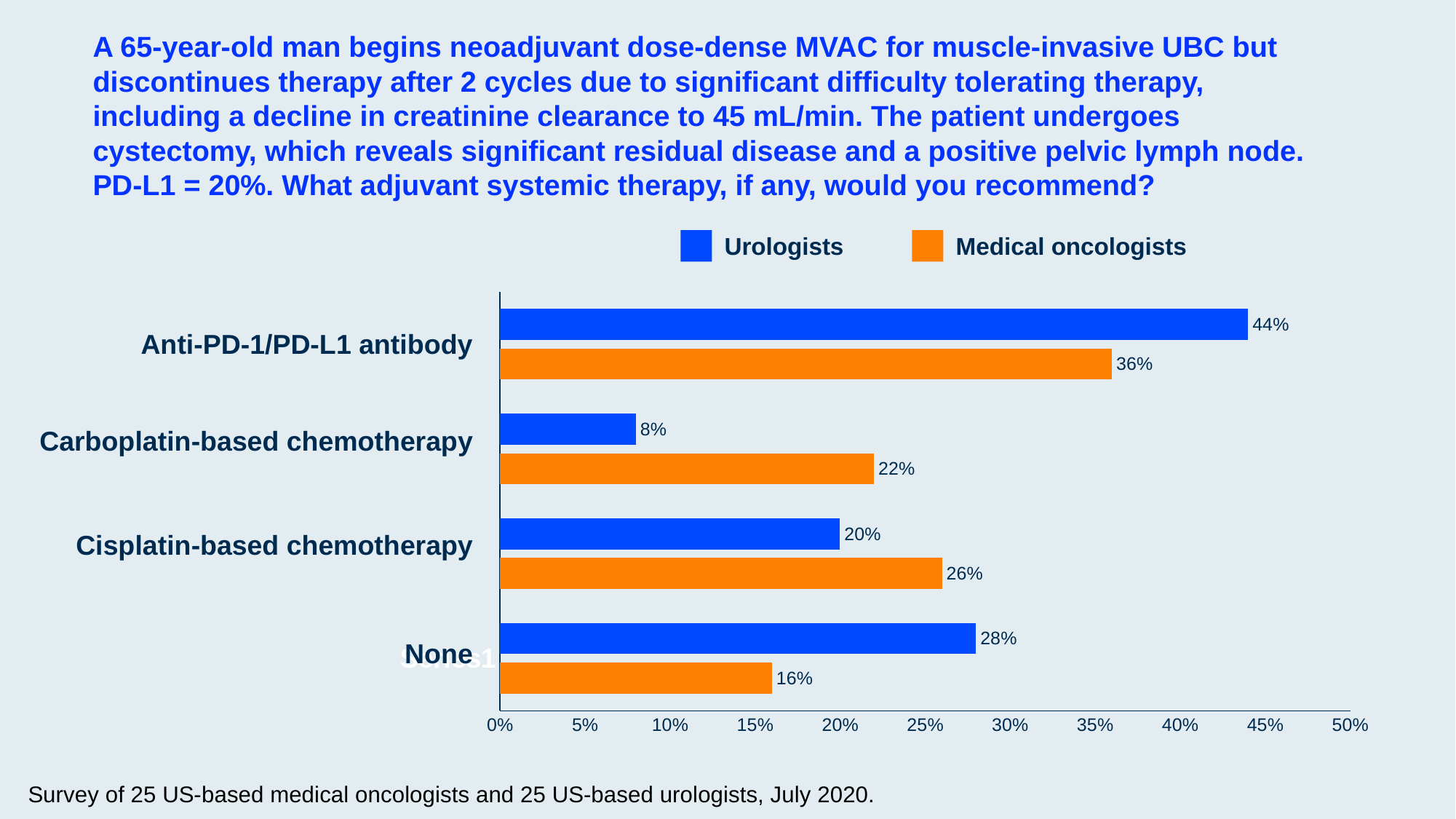
Which colour represents medical oncologists in the chart? Orange Which option received the highest percentage among urologists? Anti-PD-1/PD-L1 antibody Which option received the lowest percentage among medical oncologists? None How many answer options (categories) are shown on the chart? 4 What kind of chart is shown on the slide? Bar chart How many series does the legend list? 2 What percentage of urologists recommended an anti-PD-1/PD-L1 antibody? 44% For carboplatin-based chemotherapy, which group had the larger percentage, urologists or medical oncologists? Medical oncologists What percentage of medical oncologists recommended no adjuvant therapy (None)? 16% What percentage of medical oncologists recommended carboplatin-based chemotherapy? 22% Which option received the lowest percentage among urologists? Carboplatin-based chemotherapy What is the difference between the urologist and medical oncologist percentages for cisplatin-based chemotherapy? 6%